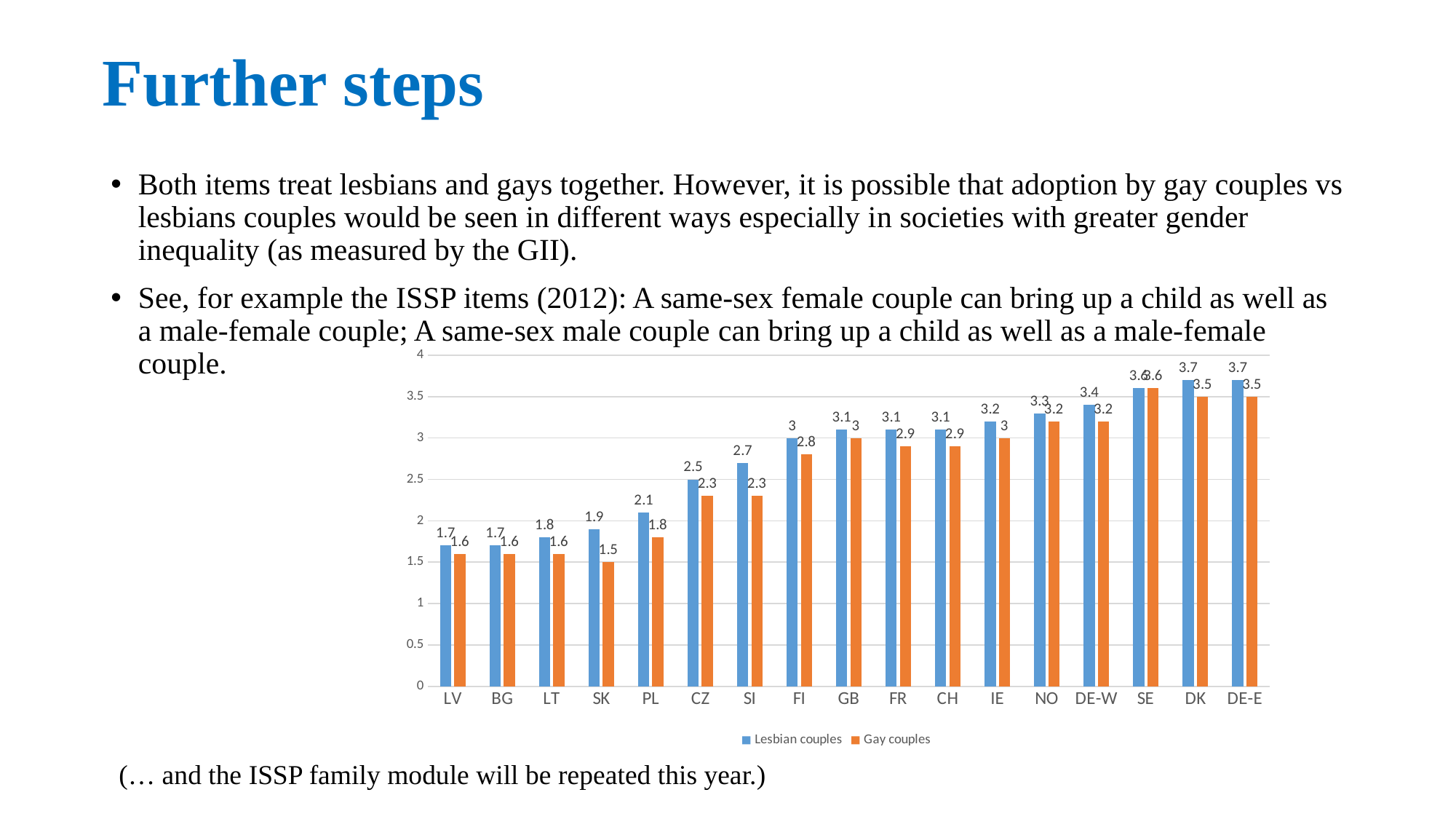
What is the value for Lesbian couples in DE-W? 3.4 What is the value for Lesbian couples in SI? 2.7 Which country has the lowest value for Gay couples? SK How many countries are shown on the x axis of the chart? 17 What type of chart is shown on the slide? bar chart Which is larger in CZ: the value for Lesbian couples or for Gay couples? Lesbian couples How many series does the chart legend list? 2 What is the value for Gay couples in PL? 1.8 Which colour represents Gay couples in the chart? orange Do the values for Lesbian couples generally rise or fall from LV to DE-E along the x axis? rise What is the difference between the Lesbian couples and Gay couples values in SK? 0.4 Which country has the highest value for Gay couples? SE